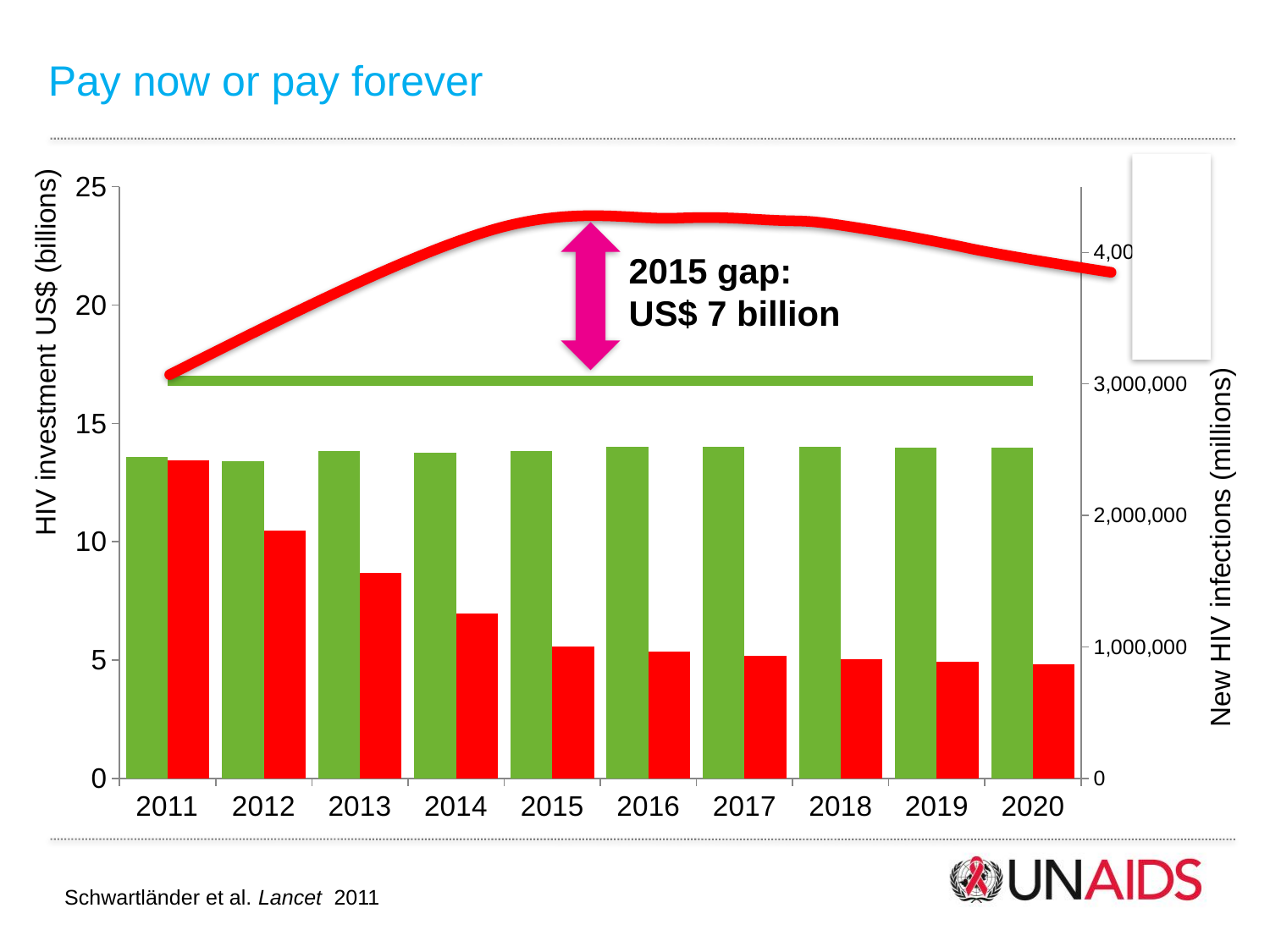
Which is taller in 2014, the green bar or the red bar? the green bar Is the green bar for 2016 greater or less than 15 on the left axis? less In which year is the red bar the tallest? 2011 Is the red bar for 2014 greater or less than 10 on the left axis? less Do the red bars rise or fall from 2011 to 2020? fall What is the last year shown on the x axis of the chart? 2020 What is the title of the left vertical axis of the chart? HIV investment US$ (billions) How many years are shown on the x axis of the chart? 10 What gap for 2015 is annotated on the chart? US$ 7 billion Is the red bar for 2011 greater or less than 10 on the left axis? greater Which is taller, the red bar for 2012 or the red bar for 2013? 2012 What is the first year shown on the x axis of the chart? 2011